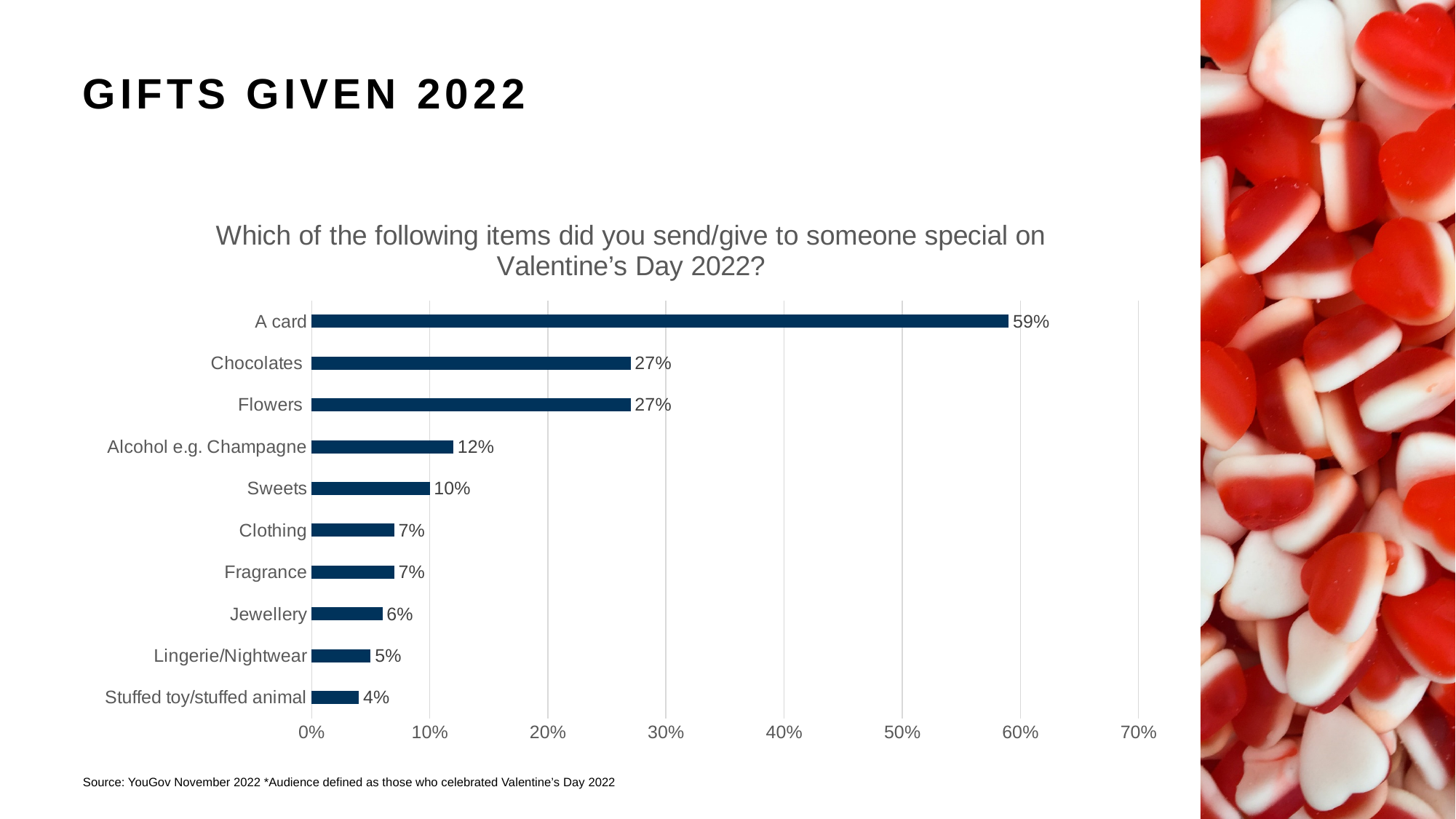
Which is larger, the value for Sweets or the value for Lingerie/Nightwear? Sweets What is the difference between the value for A card and the value for Chocolates? 32% Which item has the highest percentage? A card What is the value for Alcohol e.g. Champagne? 12% Is the value for A card greater or less than 50%? greater Which item has the lowest percentage? Stuffed toy/stuffed animal What percentage of respondents gave a card? 59% How many items are shown in the chart? 10 What is the difference between Sweets and Jewellery? 4% What is the title of the chart? Which of the following items did you send/give to someone special on Valentine's Day 2022? What percentage gave a stuffed toy/stuffed animal? 4% What kind of chart is shown on the slide? Bar chart